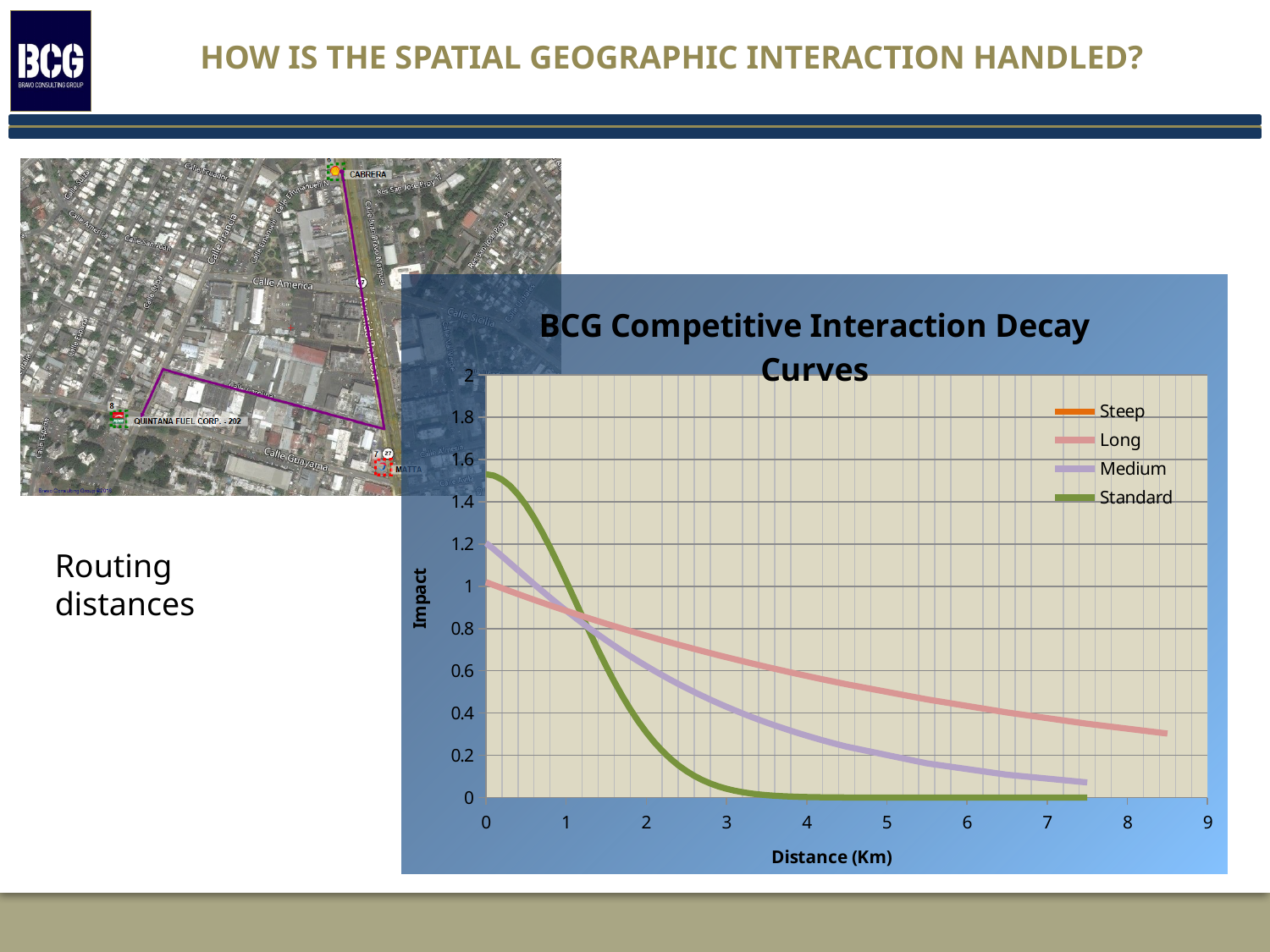
In the 'BCG Competitive Interaction Decay Curves' chart, does the Long curve rise or fall as distance increases? fall In the 'BCG Competitive Interaction Decay Curves' chart, which curve has the higher Impact at distance 4, Long or Medium? Long How many series does the legend of the 'BCG Competitive Interaction Decay Curves' chart list? 4 What kind of chart is the 'BCG Competitive Interaction Decay Curves' chart? line chart In the 'BCG Competitive Interaction Decay Curves' chart, is the Impact of the Long curve at distance 4 greater or less than 0.4? greater In the 'BCG Competitive Interaction Decay Curves' chart, which curve has the higher Impact at distance 0, Standard or Long? Standard In the 'BCG Competitive Interaction Decay Curves' chart, is the Impact of the Long curve at distance 0 greater or less than 1.2? less In the 'BCG Competitive Interaction Decay Curves' chart, does the Standard curve rise or fall as distance increases? fall In the 'BCG Competitive Interaction Decay Curves' chart, is the Impact of the Standard curve at distance 4 greater or less than 0.2? less What is the title of the chart on the slide? BCG Competitive Interaction Decay Curves What is the label of the x axis of the 'BCG Competitive Interaction Decay Curves' chart? Distance (Km)